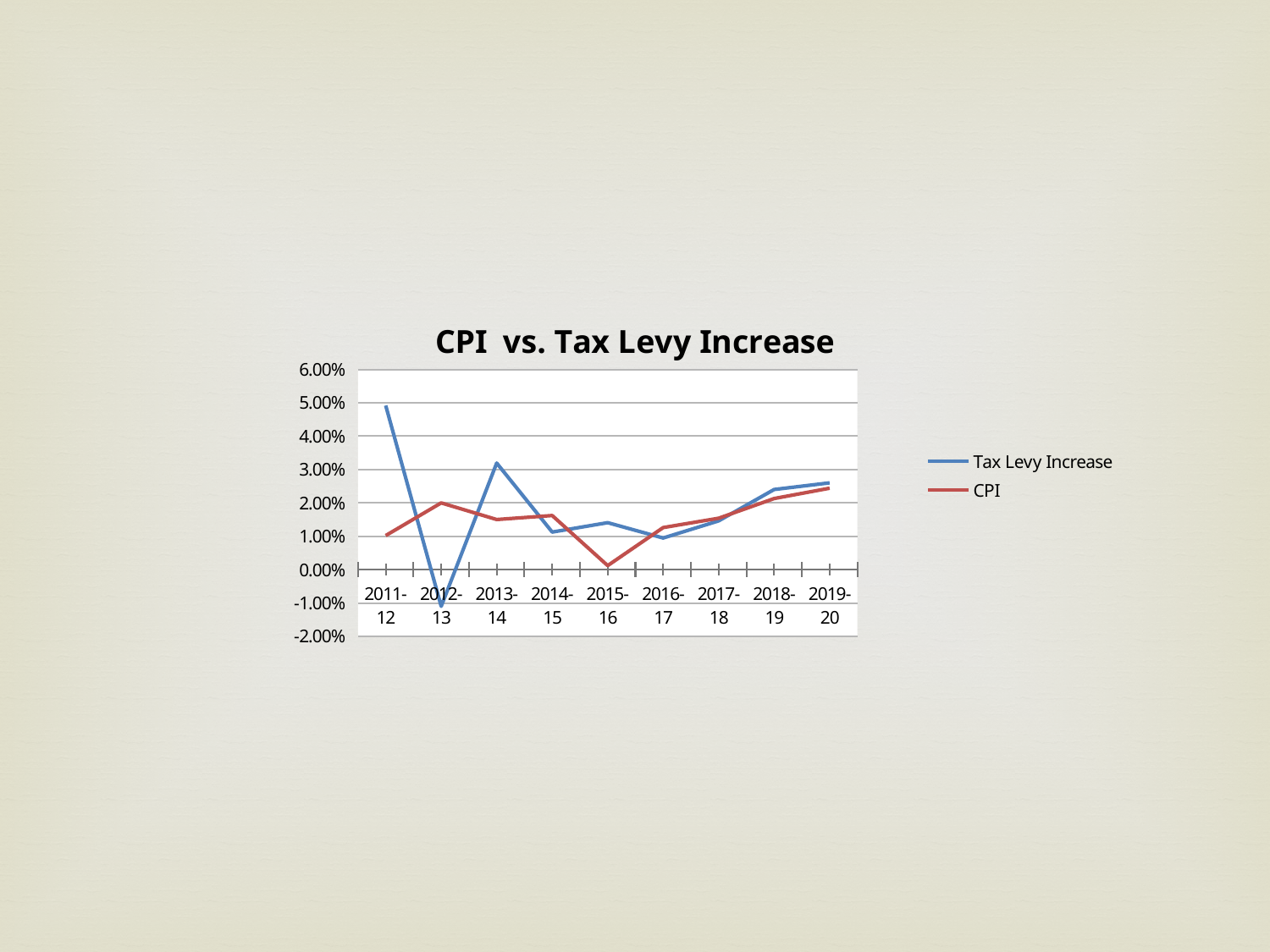
Is the Tax Levy Increase for 2012-13 greater or less than 0.00%? less Which is larger in 2012-13, CPI or Tax Levy Increase? CPI Does CPI rise or fall from 2015-16 to 2019-20? rise How many fiscal years are plotted along the x axis? 9 Which series is drawn in blue? Tax Levy Increase How many series does the legend list? 2 What is the title of the chart? CPI vs. Tax Levy Increase In which year is the Tax Levy Increase highest? 2011-12 In which year is CPI lowest? 2015-16 What kind of chart is shown on the slide? line chart In which year is the Tax Levy Increase lowest? 2012-13 Is the Tax Levy Increase for 2011-12 greater or less than 4.00%? greater